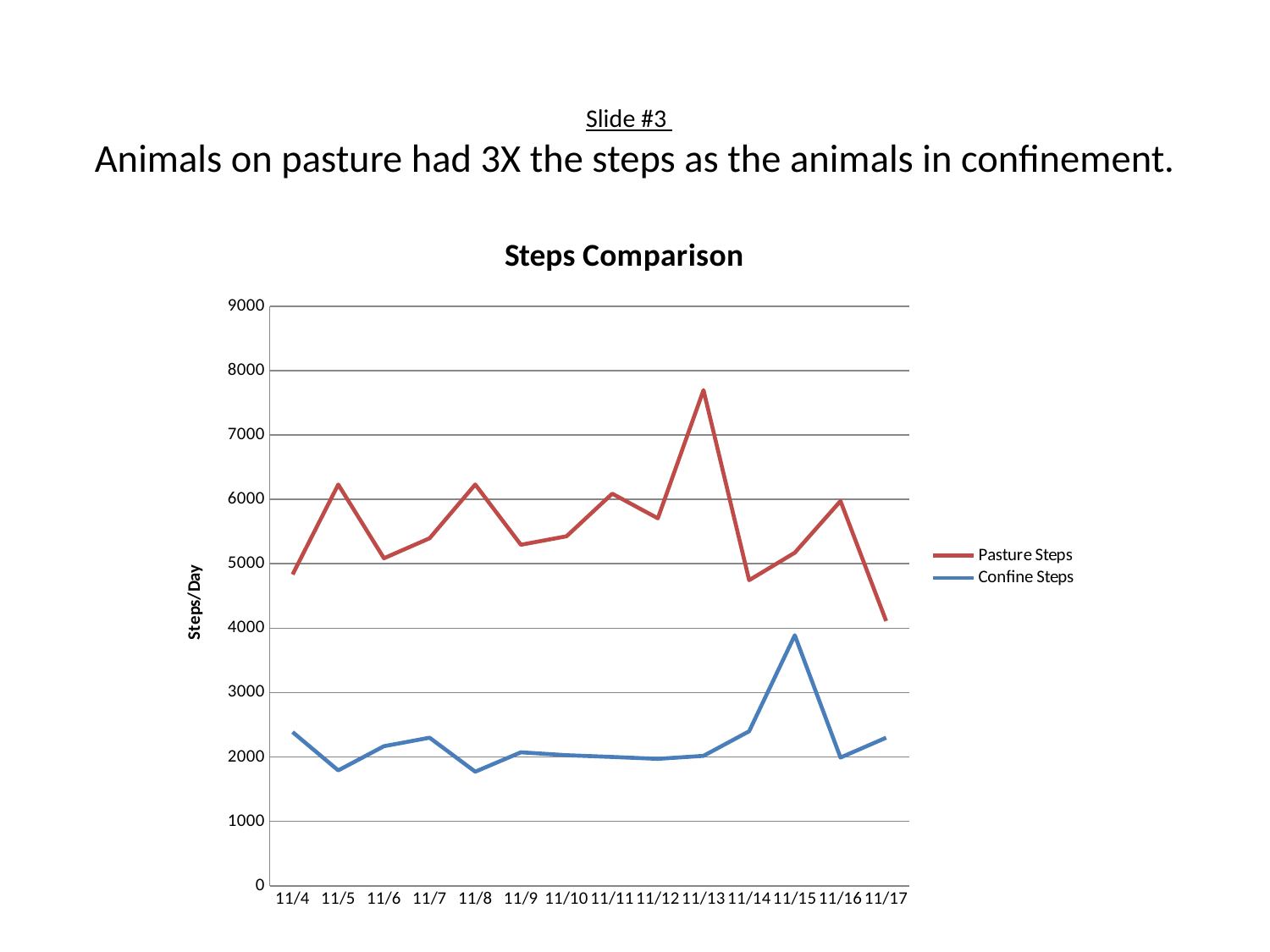
On which date does Pasture Steps reach its highest value? 11/13 Which series has the larger value on 11/10, Pasture Steps or Confine Steps? Pasture Steps What is the label on the y axis of the chart? Steps/Day How many series does the legend list? 2 Is the Pasture Steps value on 11/13 greater or less than 7000? greater On which date is Pasture Steps at its lowest? 11/17 Is the Confine Steps value on 11/15 greater or less than 3000? greater Does Confine Steps rise or fall from 11/15 to 11/16? fall How many dates are plotted along the x axis? 14 What kind of chart is shown on the slide? line chart On which date does Confine Steps reach its highest value? 11/15 Is the Pasture Steps value on 11/14 greater or less than 5000? less